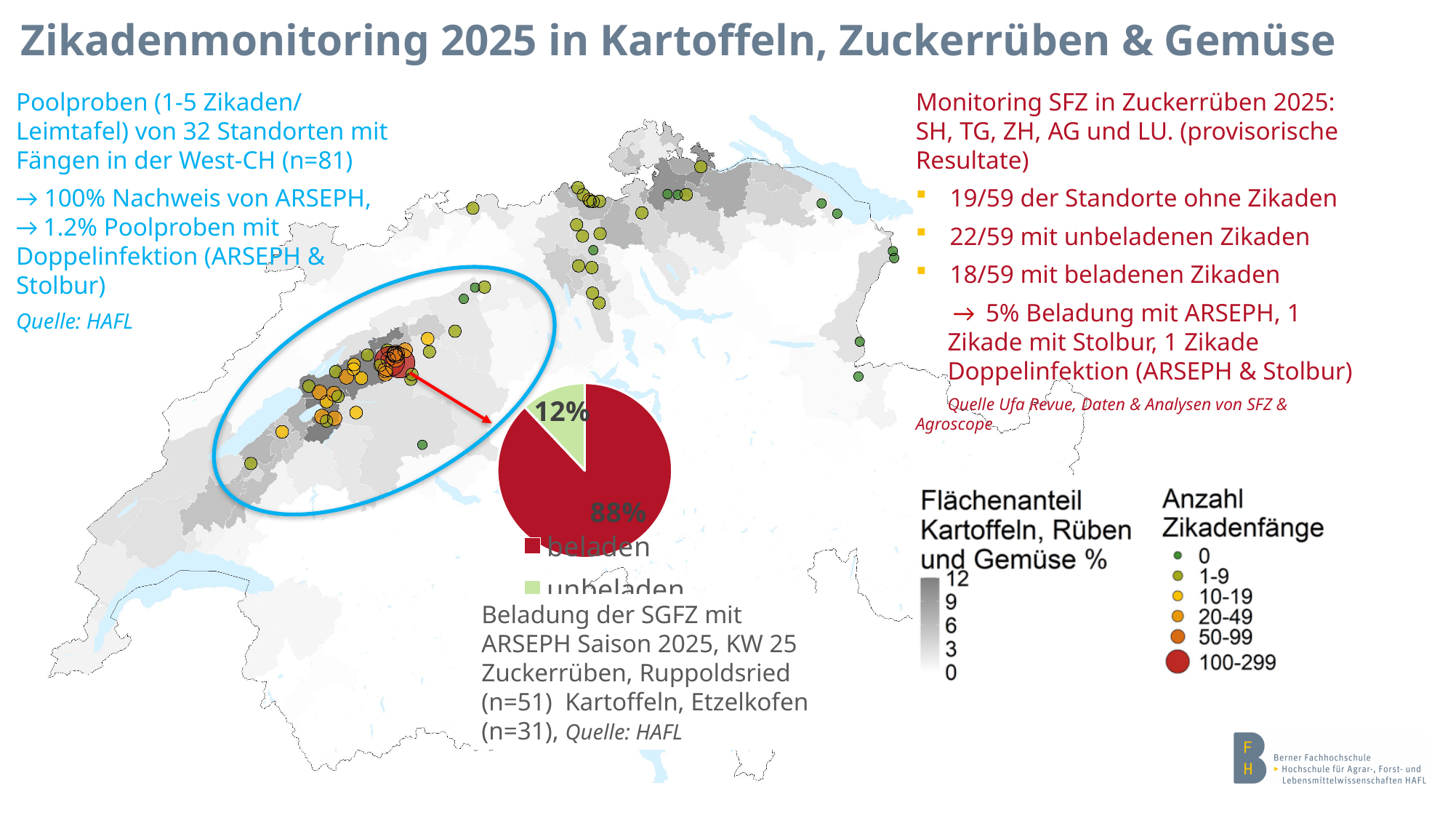
What is the difference in percentage points between the "beladen" and "unbeladen" slices of the pie chart? 76 Which slice of the pie chart is the smallest? unbeladen How many slices does the pie chart have? 2 What colour is the "beladen" slice of the pie chart? dark red What share of the pie chart is labelled "unbeladen"? 12% What is the total of the two slices shown in the pie chart? 100% Which is larger in the pie chart, "beladen" or "unbeladen"? beladen What colour is the "unbeladen" slice of the pie chart? light green What kind of chart is shown on the slide? pie chart How many entries does the pie chart's legend list? 2 What share of the pie chart is labelled "beladen"? 88% Which slice of the pie chart is the largest? beladen